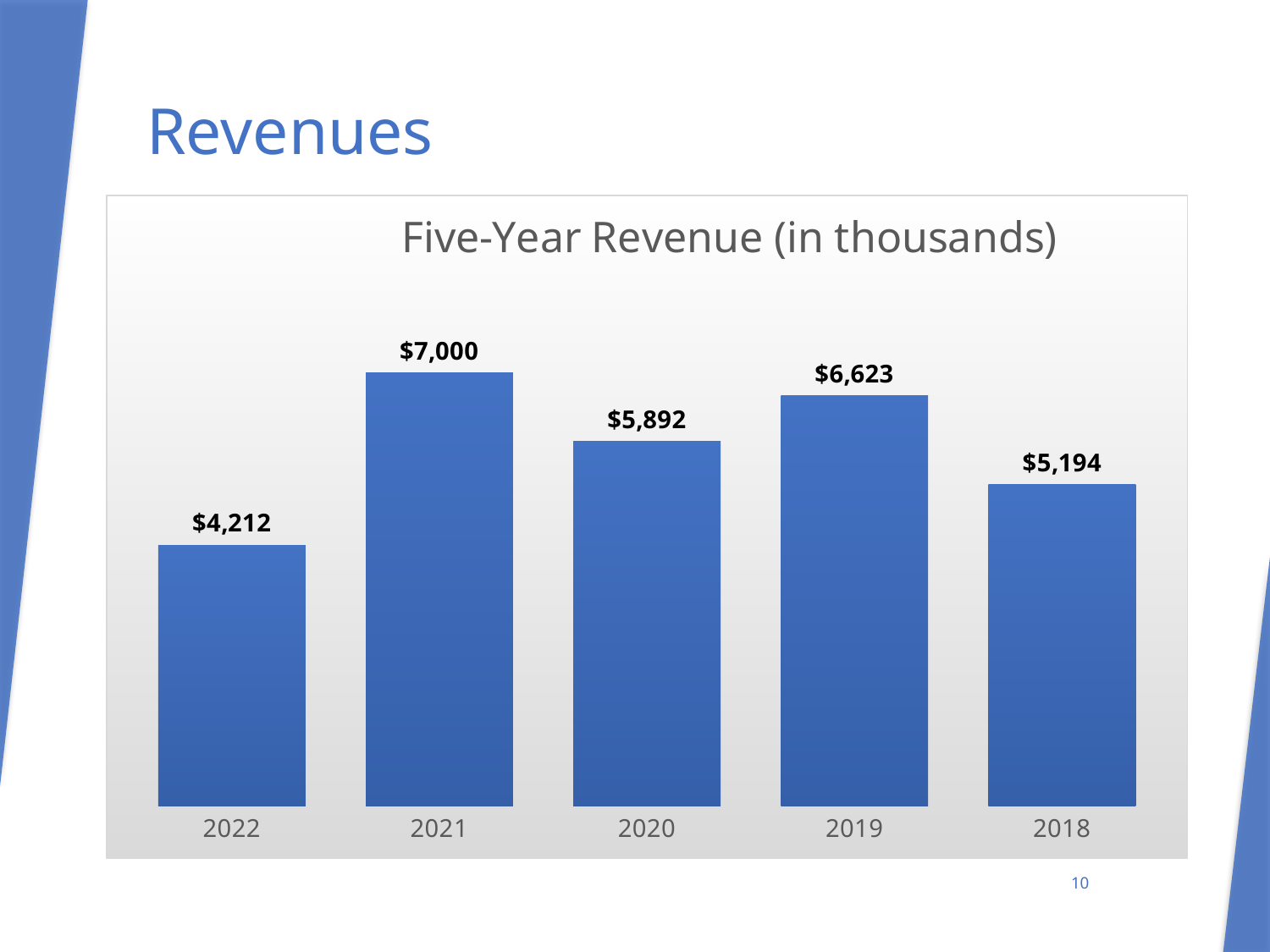
How many years are shown on the chart? 5 Which year has the lowest revenue? 2022 What is the revenue value shown for 2019? $6,623 What is the title of the chart? Five-Year Revenue (in thousands) What is the revenue value shown for 2022? $4,212 What is the difference between the revenue for 2021 and the revenue for 2022? $2,788 What is the revenue value shown for 2018? $5,194 Which year has the highest revenue? 2021 What is the total revenue across all five years shown? $28,921 What kind of chart is shown on the slide? Bar chart What is the difference between the revenue for 2020 and the revenue for 2018? $698 Which is larger, the revenue for 2020 or the revenue for 2019? 2019